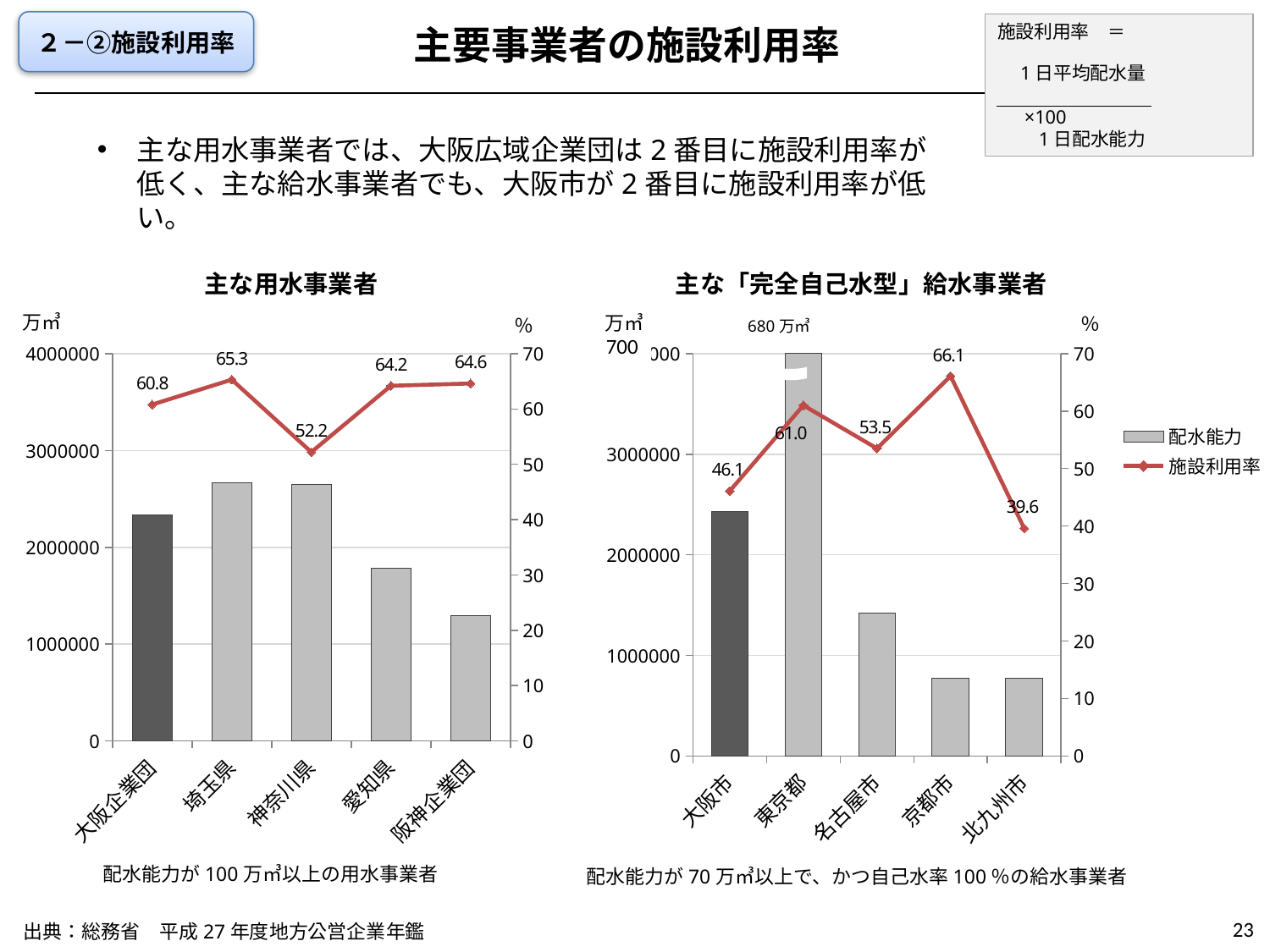
In the 主な「完全自己水型」給水事業者 chart, which has a higher 施設利用率, 大阪市 or 名古屋市? 名古屋市 In the 主な用水事業者 chart, what is the 施設利用率 for 大阪企業団? 60.8 In the 主な「完全自己水型」給水事業者 chart, is the 配水能力 bar for 名古屋市 greater or less than 2000000? less In the 主な用水事業者 chart, which category has the lowest 施設利用率? 神奈川県 In the 主な用水事業者 chart, what is the difference in 施設利用率 between 埼玉県 and 神奈川県? 13.1 How many series does the legend on the slide list? 2 In the 主な用水事業者 chart, how many categories are shown on the x axis? 5 In the 主な用水事業者 chart, is the 配水能力 bar for 阪神企業団 greater or less than 2000000? less In the 主な「完全自己水型」給水事業者 chart, which category has the highest 施設利用率? 京都市 In the 主な「完全自己水型」給水事業者 chart, what 配水能力 value is labeled for 東京都? 680 万㎥ In the 主な用水事業者 chart, which category has the highest 施設利用率? 埼玉県 In the 主な「完全自己水型」給水事業者 chart, what is the 施設利用率 for 北九州市? 39.6